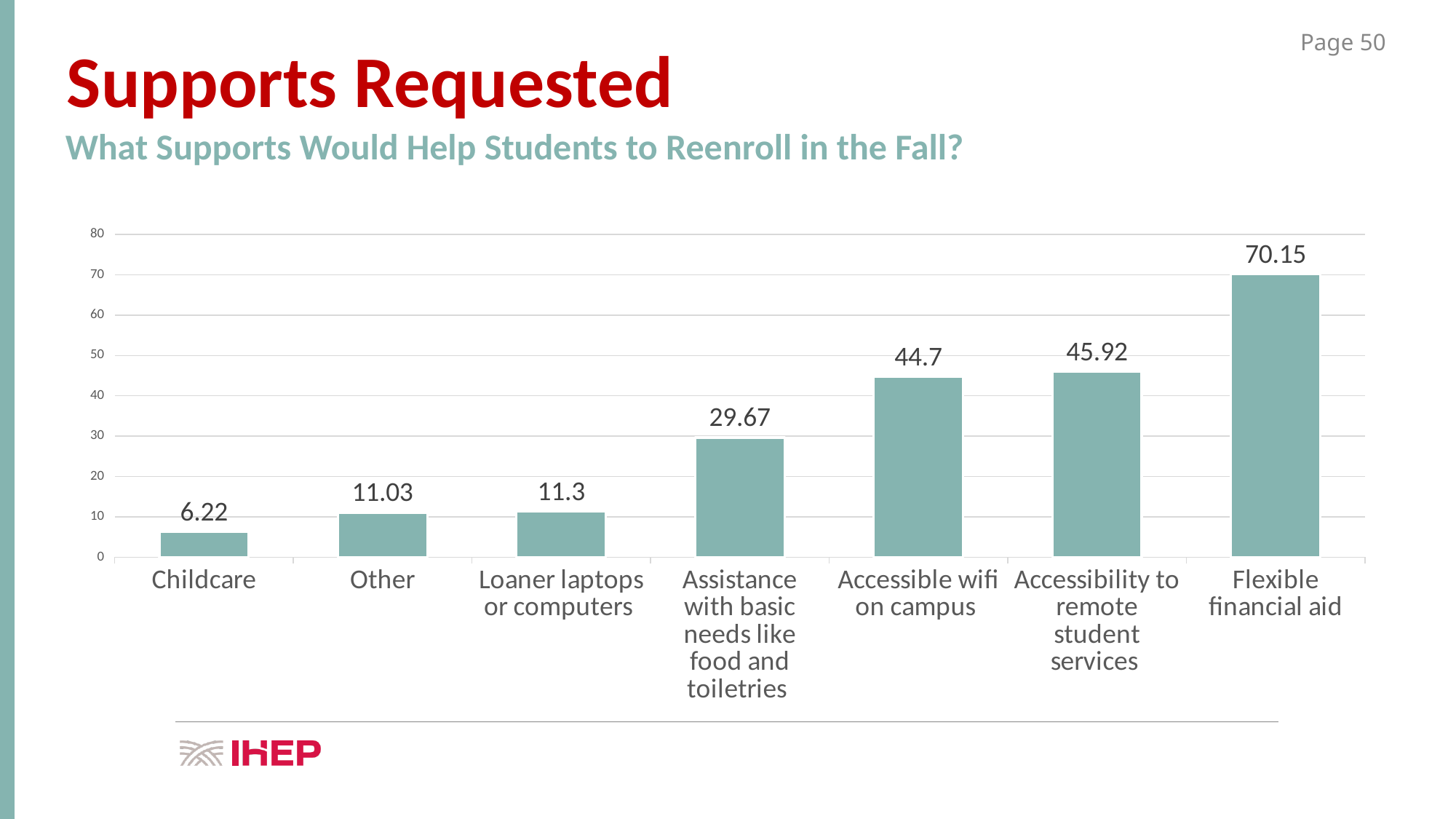
Which category has the highest value? Flexible financial aid Do the values generally rise or fall from left to right along the x axis? Rise What is the value for Flexible financial aid? 70.15 What is the value for Accessible wifi on campus? 44.7 How many categories are shown in the chart? 7 What is the value for Childcare? 6.22 What kind of chart is shown on the slide? Bar chart What is the difference between the values for Loaner laptops or computers and Other? 0.27 Which category has the lowest value? Childcare What is the difference between the values for Flexible financial aid and Accessibility to remote student services? 24.23 Which is larger, the value for Accessibility to remote student services or the value for Assistance with basic needs like food and toiletries? Accessibility to remote student services What is the value for Assistance with basic needs like food and toiletries? 29.67